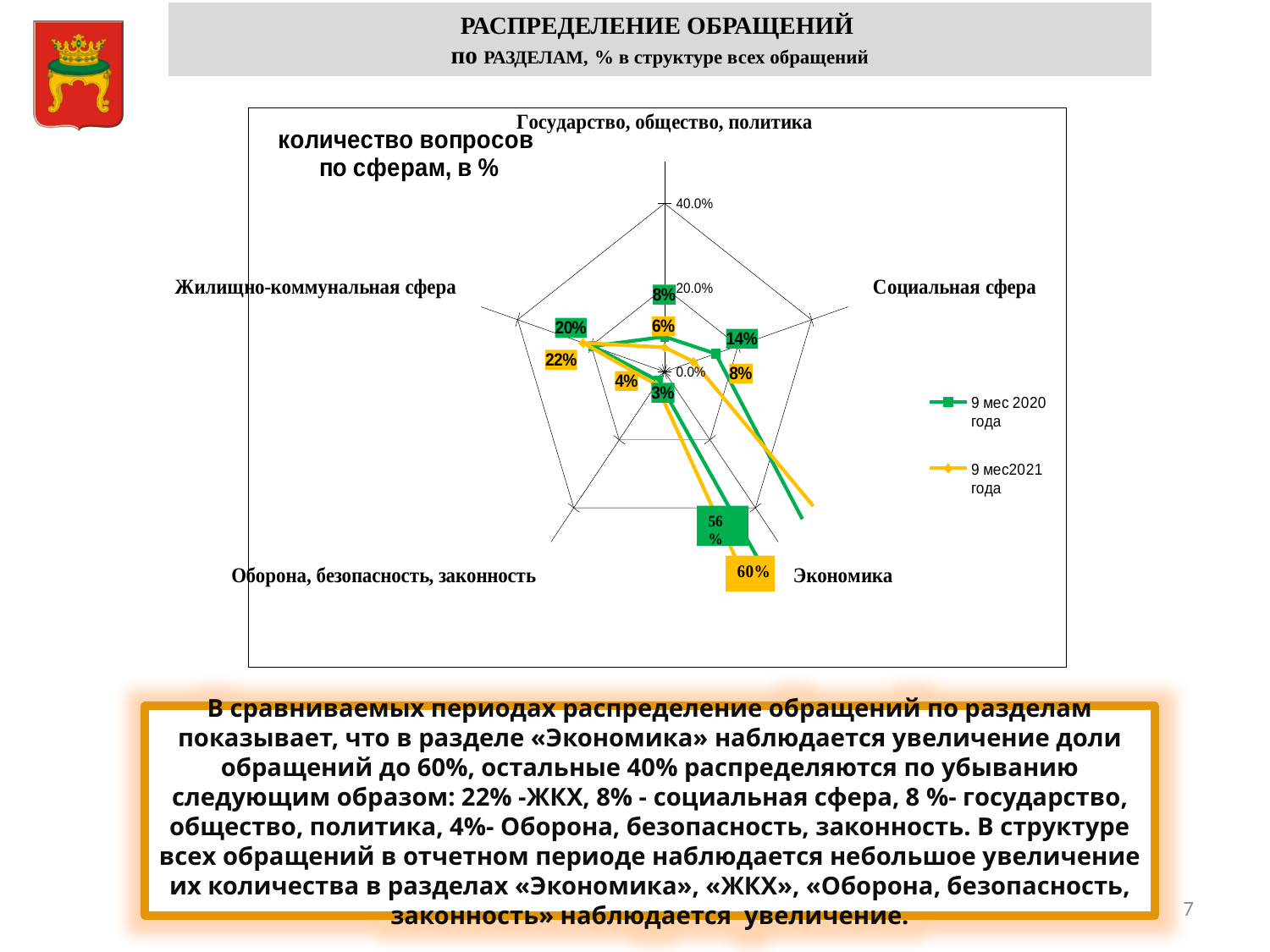
What is the value for Экономика in the 9 мес2021 года series? 60% What is the value for Жилищно-коммунальная сфера in the 9 мес2021 года series? 22% Which category has the highest value in the 9 мес2021 года series? Экономика By how many percentage points does the Экономика value for 9 мес2021 года exceed the value for 9 мес 2020 года? 4 percentage points For Социальная сфера, which series has the larger value: 9 мес 2020 года or 9 мес2021 года? 9 мес 2020 года How many categories (axes) does the chart have? 5 Which category has the lowest value in the 9 мес 2020 года series? Оборона, безопасность, законность How many series does the legend list? 2 What is the value for Экономика in the 9 мес 2020 года series? 56% Is the value for Экономика in the 9 мес2021 года series greater or less than 40.0%? greater What kind of chart is shown on the slide? Radar chart What is the value for Социальная сфера in the 9 мес 2020 года series? 14%